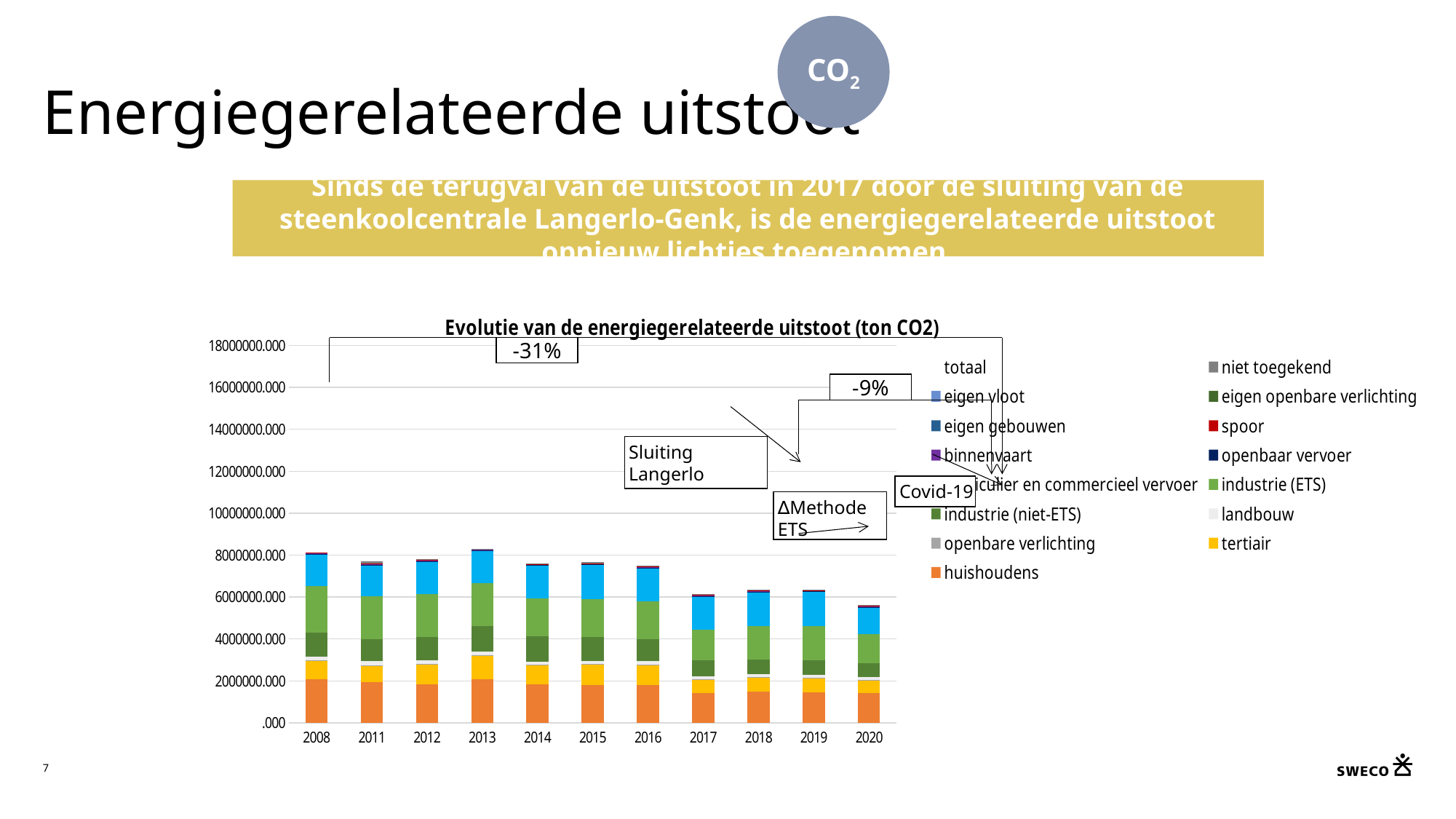
What is the title of the chart? Evolutie van de energiegerelateerde uitstoot (ton CO2) Is the total bar for 2019 greater or less than 6000000.000? greater Is the total bar for 2013 greater or less than 8000000.000? greater Which year has the larger total bar, 2013 or 2020? 2013 How many years are shown on the x axis of the chart? 11 Is the total bar for 2016 greater or less than 8000000.000? less Which year has the larger total bar, 2016 or 2017? 2016 Which year has the lowest total bar in the chart? 2020 Do the total bars generally rise or fall from 2008 to 2020? fall What percentage change is shown in the annotation box spanning from 2008 to 2020 at the top of the chart? -31% What kind of chart is shown on the slide? Stacked bar chart